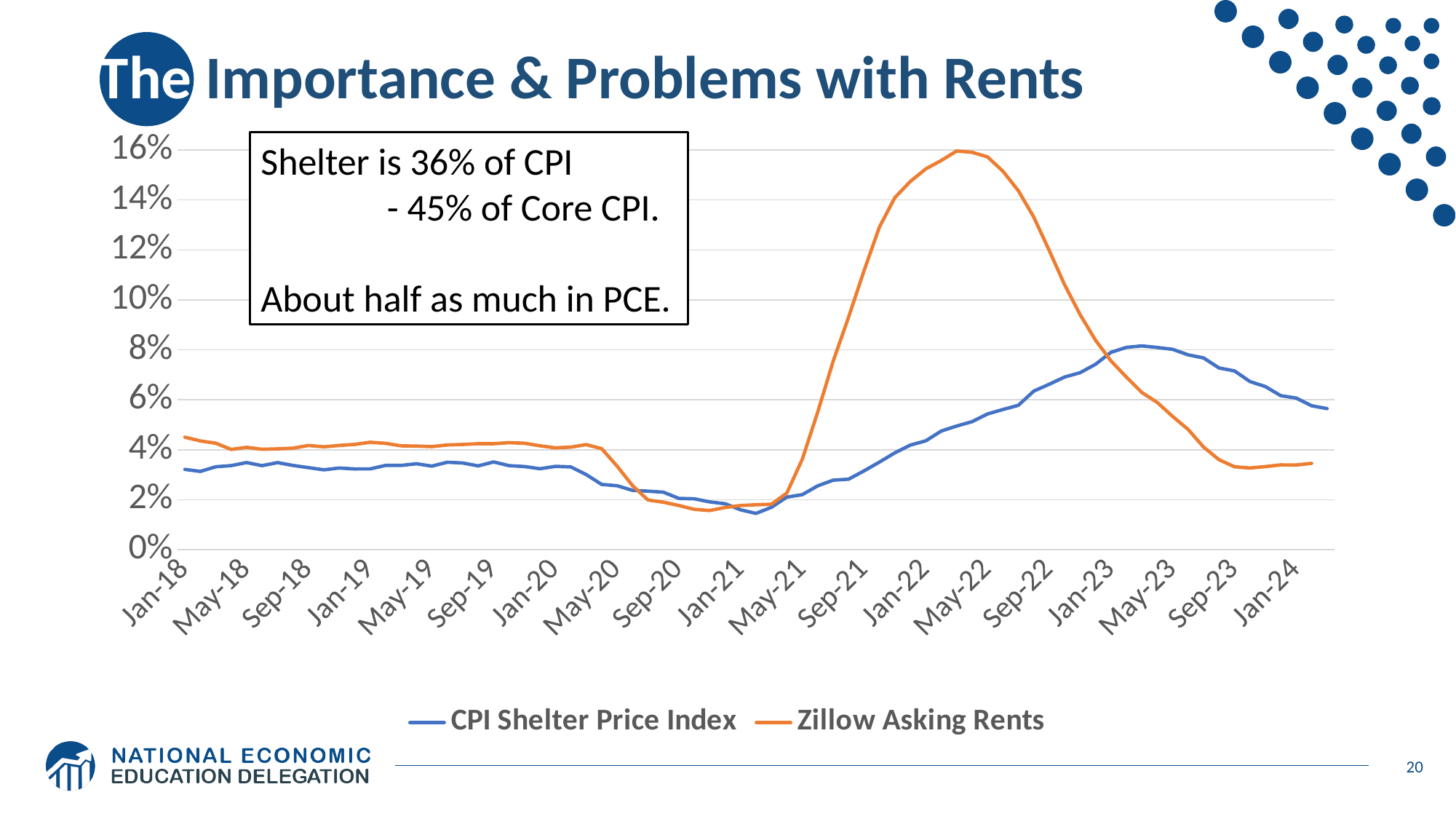
How many series does the chart's legend list? 2 Does the Zillow Asking Rents line rise or fall between May-22 and Sep-23? Falls What are the two series named in the chart legend? CPI Shelter Price Index and Zillow Asking Rents Is the value of Zillow Asking Rents at Jan-24 greater or less than 4%? less At Jan-24, which series has the higher value, CPI Shelter Price Index or Zillow Asking Rents? CPI Shelter Price Index Is the value of the CPI Shelter Price Index at Jan-18 greater or less than 4%? less Which colour is used for the Zillow Asking Rents line? Orange Is the peak value of the CPI Shelter Price Index in early 2023 greater or less than 6%? greater What kind of chart is shown on the slide? Line chart At Jan-22, which series has the higher value, CPI Shelter Price Index or Zillow Asking Rents? Zillow Asking Rents Which series reaches the highest peak on the chart? Zillow Asking Rents